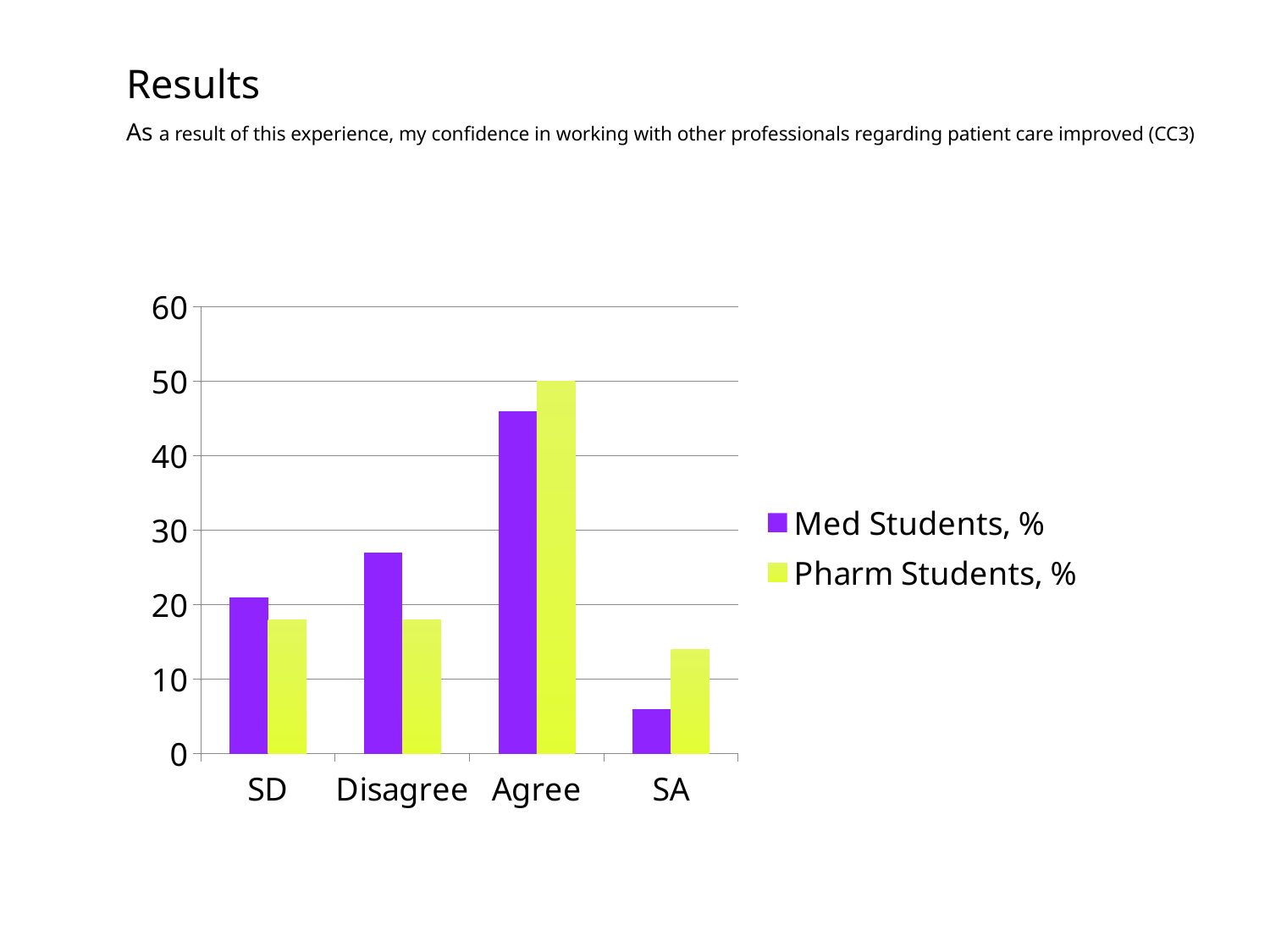
For the Agree category, which series has the larger value, Med Students, % or Pharm Students, %? Pharm Students, % Which category has the lowest value for Med Students, %? SA How many categories are shown on the x axis? 4 Is the value for Med Students, % in the SA category greater or less than 10? less Which category has the lowest value for Pharm Students, %? SA What kind of chart is shown on the slide? bar chart Is the value for Pharm Students, % in the SA category greater or less than 10? greater For the Disagree category, which series has the larger value, Med Students, % or Pharm Students, %? Med Students, % What are the two legend entries of the chart? Med Students, % and Pharm Students, % Is the value for Med Students, % in the Agree category greater or less than 40? greater How many series does the legend list? 2 Which category has the highest value for Med Students, %? Agree